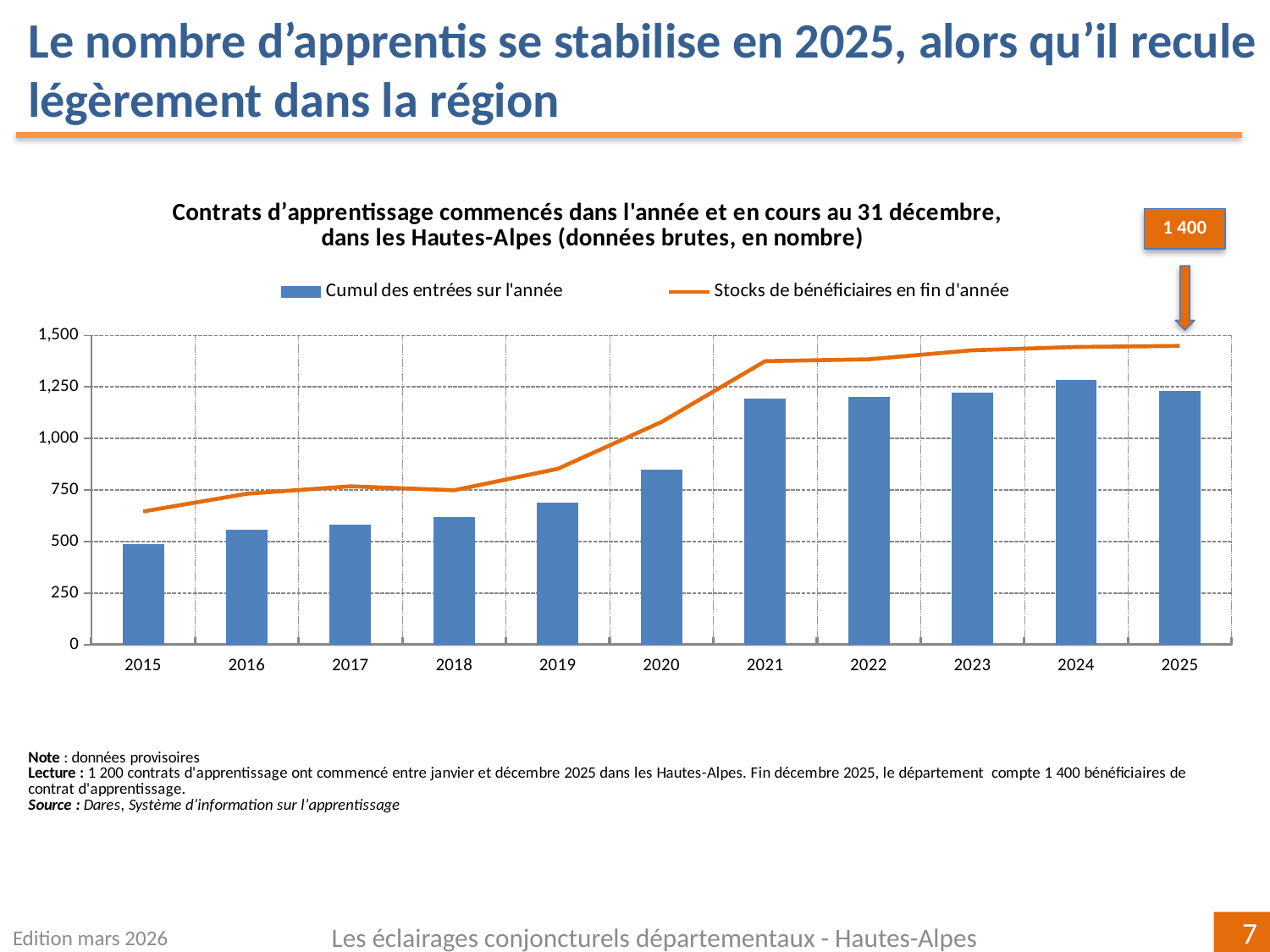
What is the value of 'Stocks de bénéficiaires en fin d'année' in 2025? 1 400 Does the line for 'Stocks de bénéficiaires en fin d'année' generally rise or fall from 2015 to 2025? Rise Is the value of 'Stocks de bénéficiaires en fin d'année' for 2021 greater or less than 1,250? greater In which year is the bar for 'Cumul des entrées sur l'année' the highest? 2024 Is the value of 'Cumul des entrées sur l'année' for 2020 greater or less than 750? greater What colour is the line for 'Stocks de bénéficiaires en fin d'année'? Orange What kind of chart is shown on the slide? A combined bar and line chart How many years are shown on the x axis? 11 Is the value of 'Cumul des entrées sur l'année' for 2018 greater or less than 750? less How many series does the legend list? 2 Which is larger in 2021: 'Cumul des entrées sur l'année' or 'Stocks de bénéficiaires en fin d'année'? Stocks de bénéficiaires en fin d'année In which year is the bar for 'Cumul des entrées sur l'année' the lowest? 2015